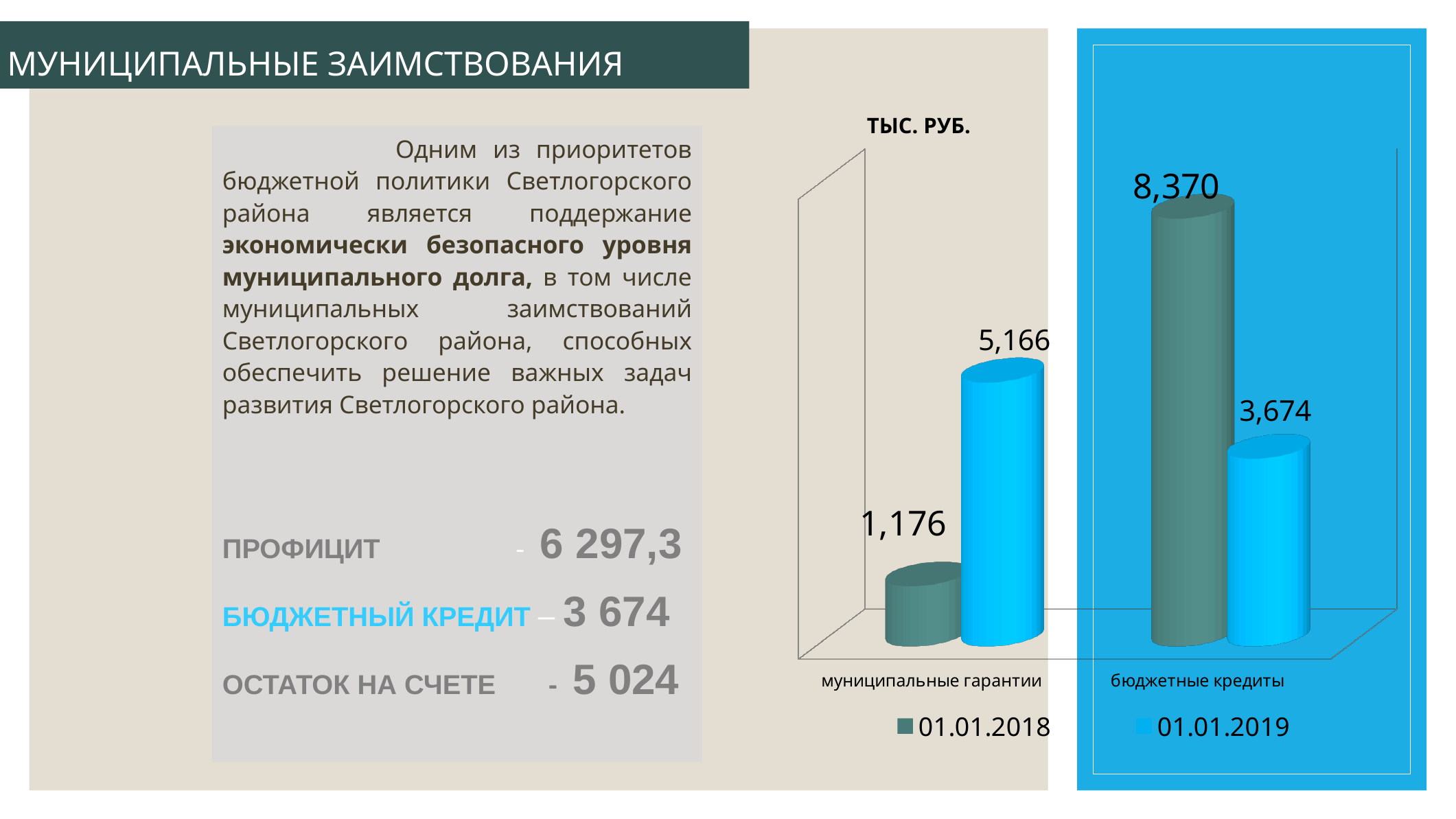
What unit is indicated above the chart? ТЫС. РУБ. What is the value for муниципальные гарантии on 01.01.2019? 5,166 What is the value for бюджетные кредиты on 01.01.2018? 8,370 What is the value for бюджетные кредиты on 01.01.2019? 3,674 What is the difference between the 01.01.2018 and 01.01.2019 values for бюджетные кредиты? 4,696 For бюджетные кредиты, which is larger: the value on 01.01.2018 or on 01.01.2019? 01.01.2018 Which bar in the chart has the highest value? бюджетные кредиты, 01.01.2018 What is the difference between the 01.01.2019 and 01.01.2018 values for муниципальные гарантии? 3,990 How many series does the chart legend list? 2 What is the value for муниципальные гарантии on 01.01.2018? 1,176 Which bar in the chart has the lowest value? муниципальные гарантии, 01.01.2018 How many categories are shown on the x axis of the chart? 2